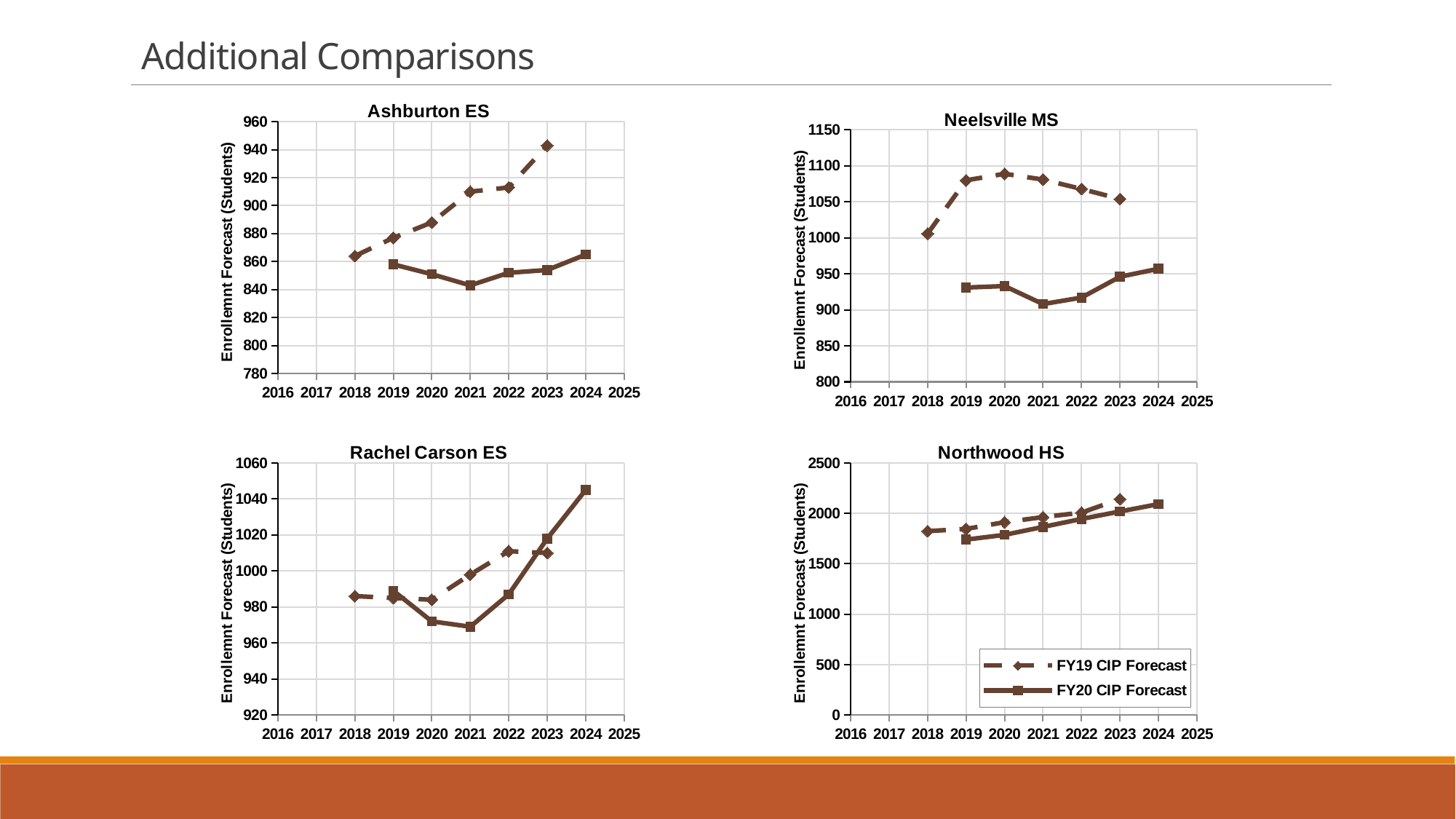
In the Ashburton ES chart, is the FY20 CIP Forecast value for 2021 greater or less than 860? less In the Neelsville MS chart, which year has the lowest FY20 CIP Forecast value? 2021 In the Ashburton ES chart, which year has the lowest FY20 CIP Forecast value? 2021 In the Ashburton ES chart, does the FY19 CIP Forecast line rise or fall from 2018 to 2023? rise In the Rachel Carson ES chart, is the FY20 CIP Forecast value for 2024 greater or less than 1040? greater In the Northwood HS chart, does the FY20 CIP Forecast line rise or fall from 2019 to 2024? rise In the Northwood HS chart, what are the two series named in the legend? FY19 CIP Forecast and FY20 CIP Forecast What kind of chart is the Ashburton ES chart? line chart In the Neelsville MS chart, is the FY19 CIP Forecast value for 2020 greater or less than 1050? greater In the Ashburton ES chart, how many data points does the dashed FY19 CIP Forecast line have? 6 In the Rachel Carson ES chart, which is larger in 2022, the FY19 CIP Forecast or the FY20 CIP Forecast? FY19 CIP Forecast In the Northwood HS chart, how many series does the legend list? 2